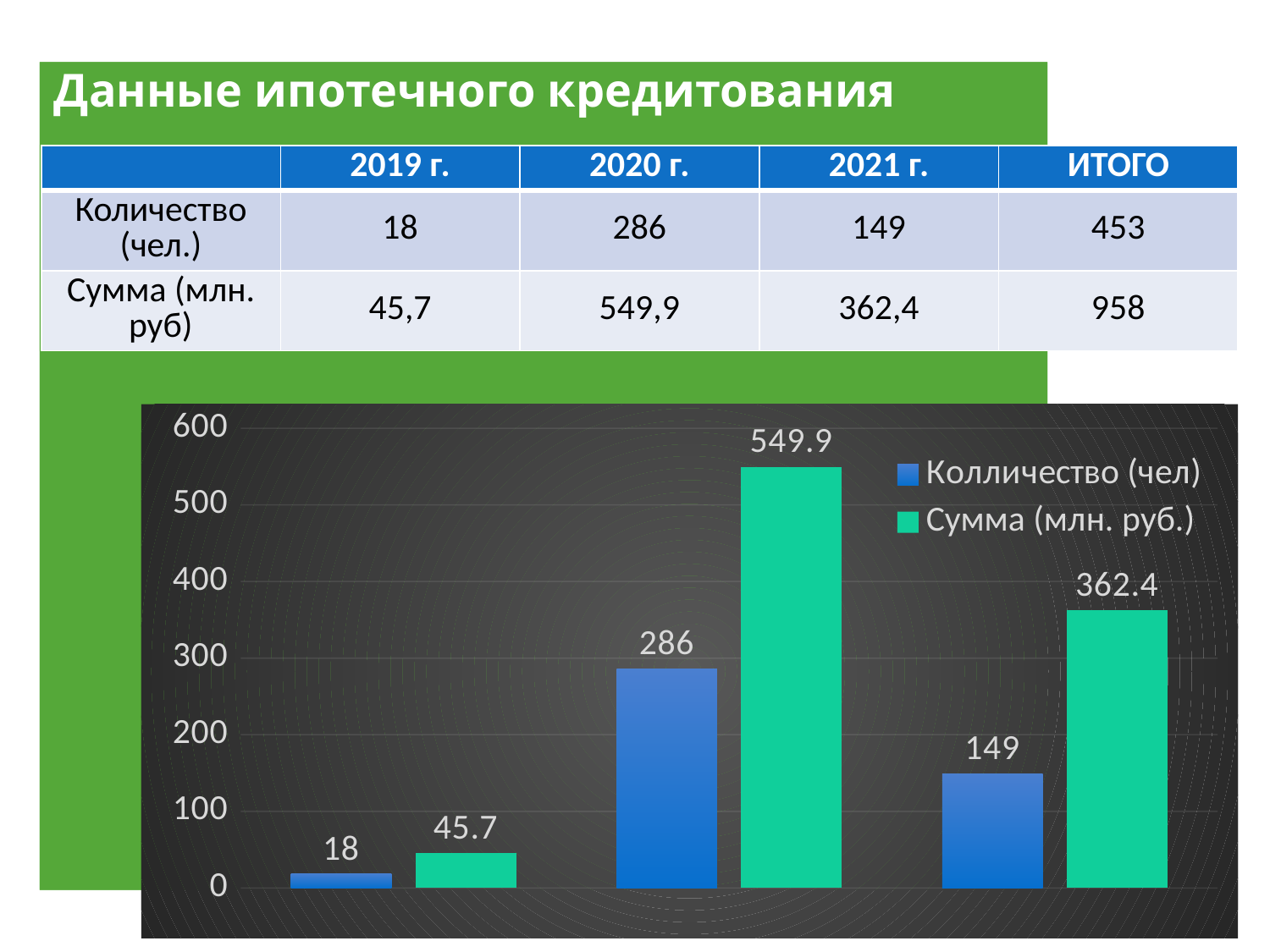
In the second group of the chart, which bar is larger: 'Колличество (чел)' or 'Сумма (млн. руб.)'? Сумма (млн. руб.) How many groups of bars are plotted in the chart? 3 What colour are the 'Сумма (млн. руб.)' bars in the chart? green Which group of bars has the lowest 'Колличество (чел)' value in the chart? the first group What is the value of the 'Сумма (млн. руб.)' bar in the third group of the chart? 362.4 What is the value of the blue 'Колличество (чел)' bar in the first group of the chart? 18 What is the difference between the 'Сумма (млн. руб.)' values of the second and third groups in the chart? 187.5 What is the value of the 'Колличество (чел)' bar in the third group of the chart? 149 What kind of chart is shown on the slide? bar chart How many series does the chart legend list? 2 What is the value of the green 'Сумма (млн. руб.)' bar in the second group of the chart? 549.9 Which group of bars has the highest 'Сумма (млн. руб.)' value in the chart? the second group